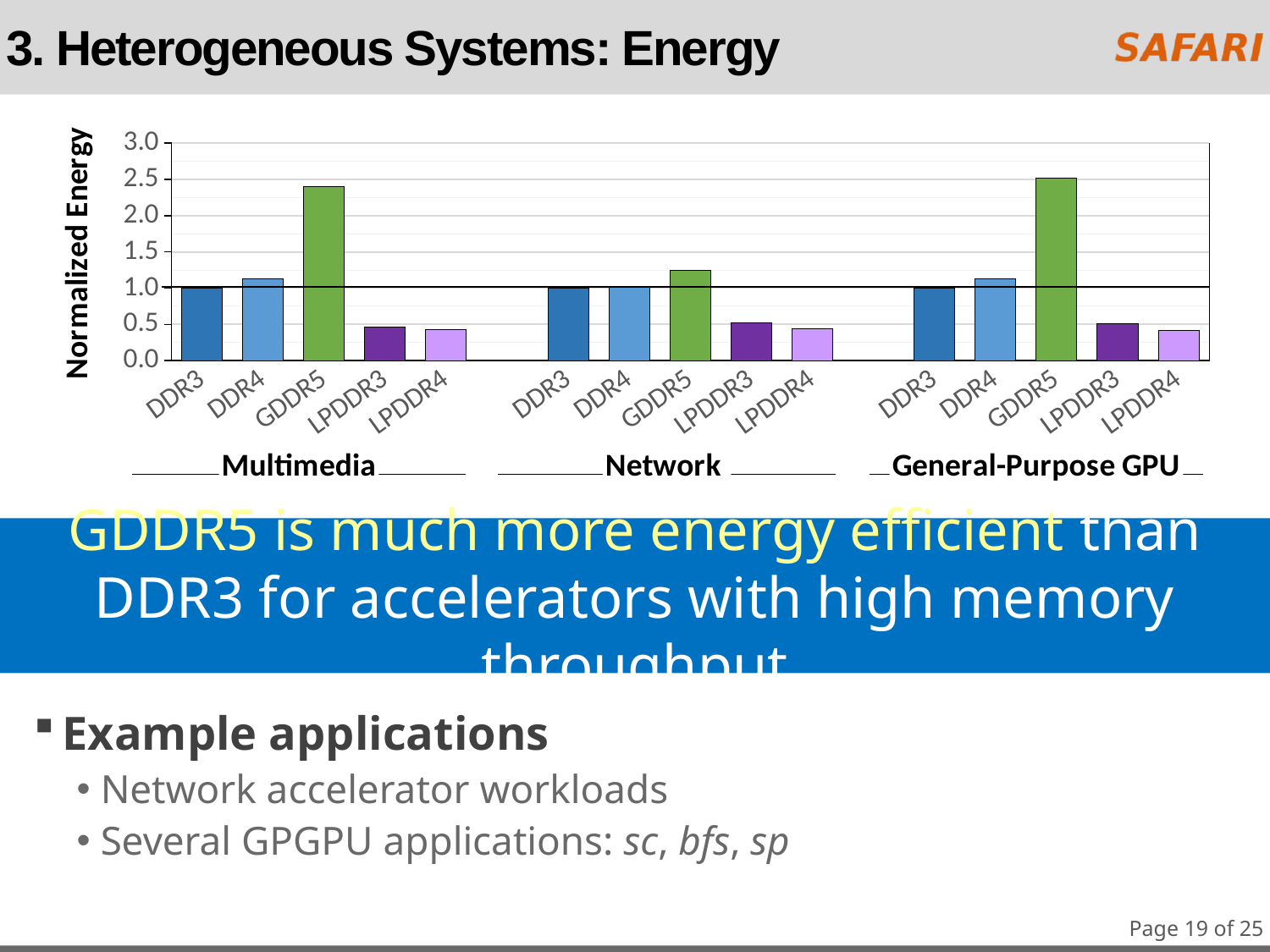
How many memory types are plotted within each application group? 5 What is the label of the y axis? Normalized Energy Which memory type has the highest normalized energy in the Multimedia group? GDDR5 Is the normalized energy of GDDR5 in the Multimedia group greater or less than 2.0? greater Is the normalized energy of LPDDR4 in the General-Purpose GPU group greater or less than 0.5? less What is the normalized energy of DDR3 in the Multimedia group? 1.0 Is the normalized energy of GDDR5 in the Network group greater or less than 1.5? less Which is larger: the normalized energy of GDDR5 in the Multimedia group or in the Network group? Multimedia Which memory type has the lowest normalized energy in the General-Purpose GPU group? LPDDR4 What kind of chart is shown on the slide? bar chart Which memory type has the highest normalized energy in the General-Purpose GPU group? GDDR5 How many application groups are shown along the x axis? 3